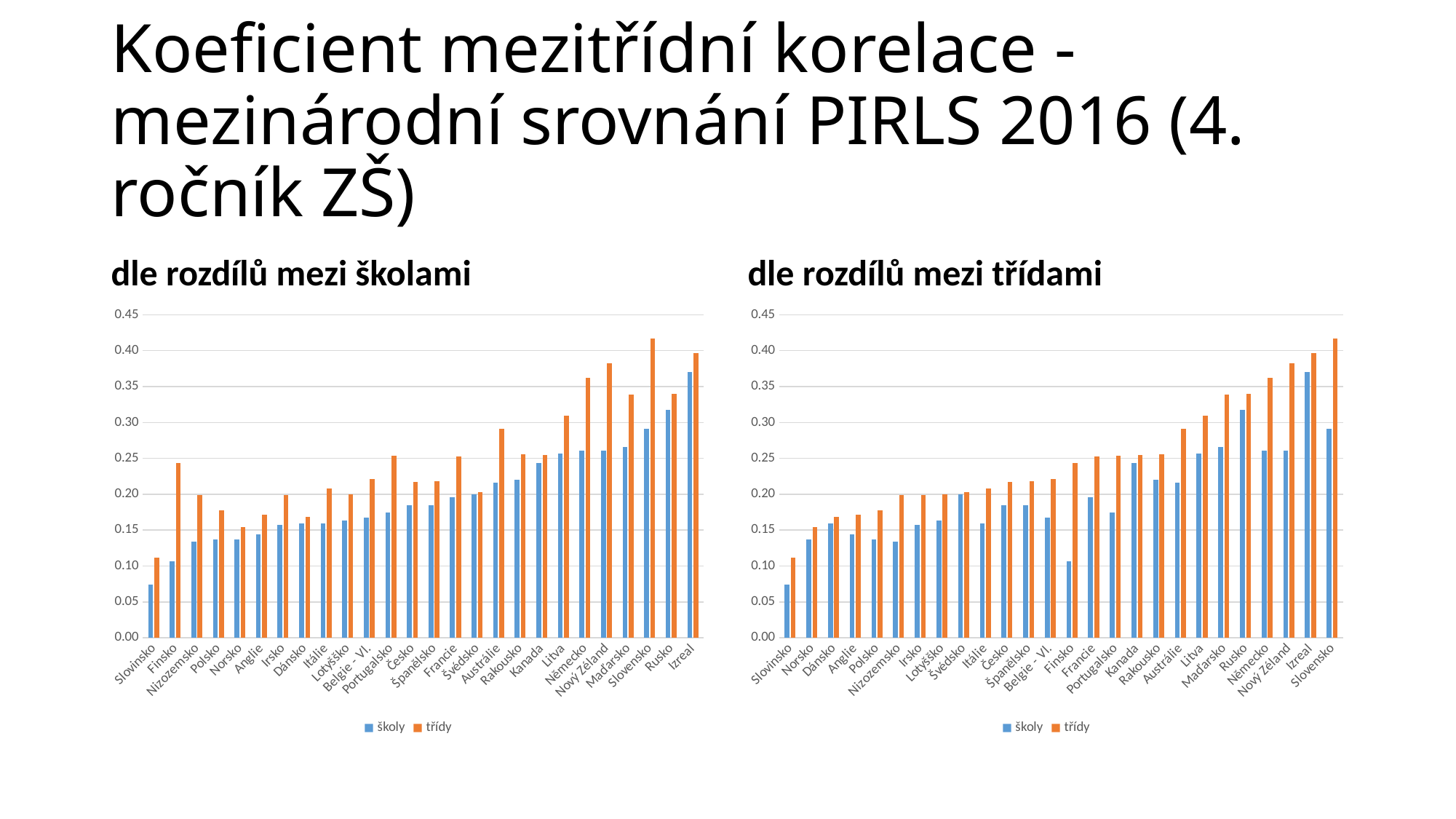
In the chart titled "dle rozdílů mezi třídami", is the třídy value for Nový Zéland greater or less than 0.35? greater In the chart titled "dle rozdílů mezi školami", is the třídy value for Finsko greater or less than 0.20? greater In the chart titled "dle rozdílů mezi školami", which country has the highest value for školy? Izreal In the chart titled "dle rozdílů mezi školami", which country has the lowest value for školy? Slovinsko In the chart titled "dle rozdílů mezi školami", which is larger for Finsko: the školy value or the třídy value? třídy In the chart titled "dle rozdílů mezi třídami", which country has the larger školy value: Slovensko or Izreal? Izreal In the chart titled "dle rozdílů mezi školami", is the školy value for Slovinsko greater or less than 0.10? less How many series does the legend of the chart titled "dle rozdílů mezi třídami" list? 2 In the chart titled "dle rozdílů mezi školami", do the školy values rise or fall from left to right along the x axis? rise How many countries are shown on the x axis of the chart titled "dle rozdílů mezi školami"? 26 In the chart titled "dle rozdílů mezi třídami", which country has the highest value for třídy? Slovensko In the chart titled "dle rozdílů mezi třídami", which country has the lowest value for třídy? Slovinsko